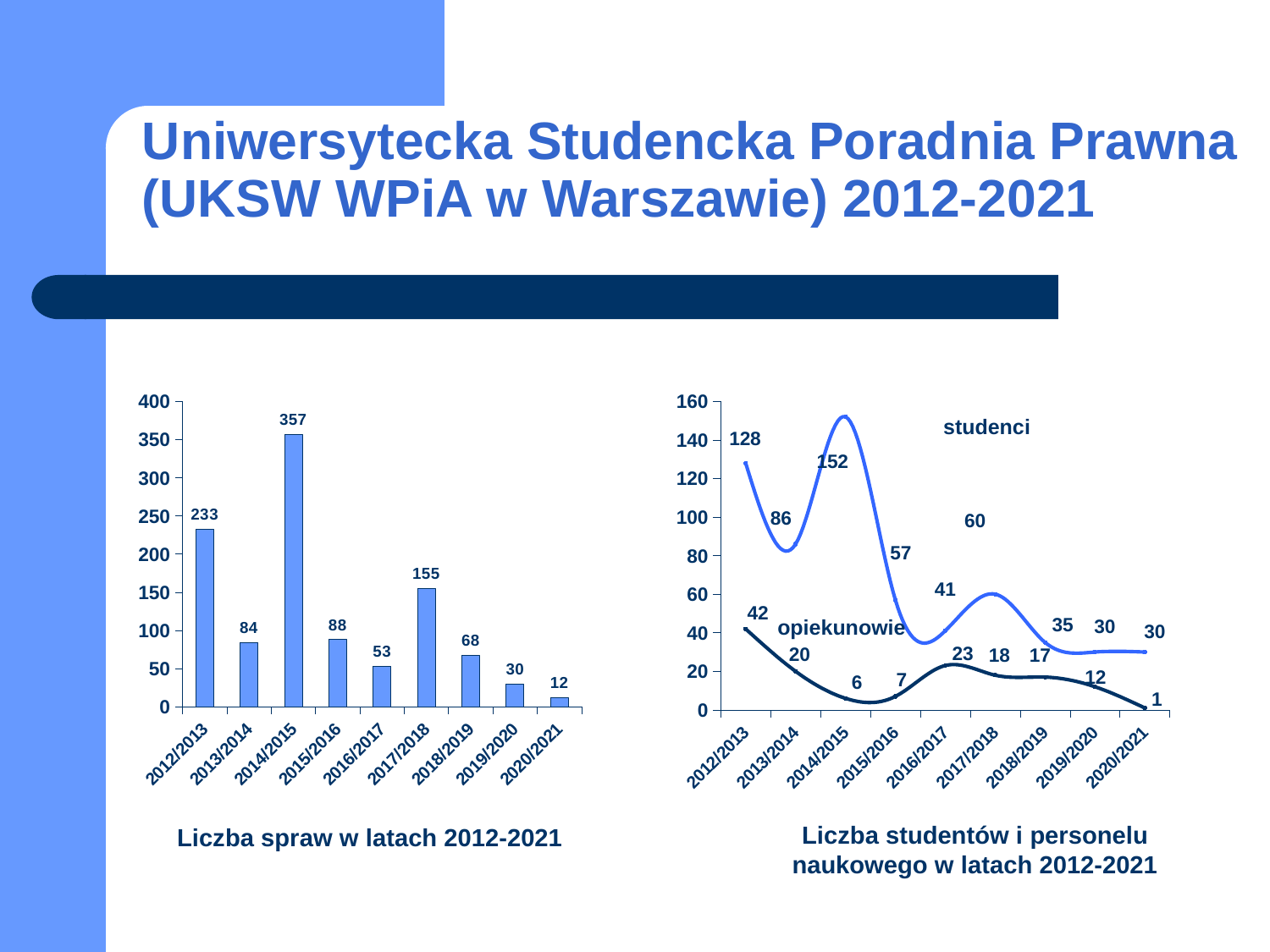
On the chart 'Liczba studentów i personelu naukowego w latach 2012-2021', what is the value for opiekunowie in 2020/2021? 1 On the chart 'Liczba spraw w latach 2012-2021', which year has the lowest value? 2020/2021 On the chart 'Liczba spraw w latach 2012-2021', which year has the highest value? 2014/2015 On the chart 'Liczba spraw w latach 2012-2021', which is larger, the value for 2015/2016 or 2018/2019? 2015/2016 On the chart 'Liczba spraw w latach 2012-2021', what is the value for 2017/2018? 155 On the chart 'Liczba spraw w latach 2012-2021', what is the value for 2014/2015? 357 On the chart 'Liczba studentów i personelu naukowego w latach 2012-2021', in which year does the studenci series reach its highest value? 2014/2015 On the chart 'Liczba spraw w latach 2012-2021', how many years are shown on the x axis? 9 On the chart 'Liczba spraw w latach 2012-2021', what is the difference between the values for 2012/2013 and 2013/2014? 149 On the chart 'Liczba studentów i personelu naukowego w latach 2012-2021', what is the value for studenci in 2012/2013? 128 What kind of chart is 'Liczba spraw w latach 2012-2021'? bar chart What kind of chart is 'Liczba studentów i personelu naukowego w latach 2012-2021'? line chart